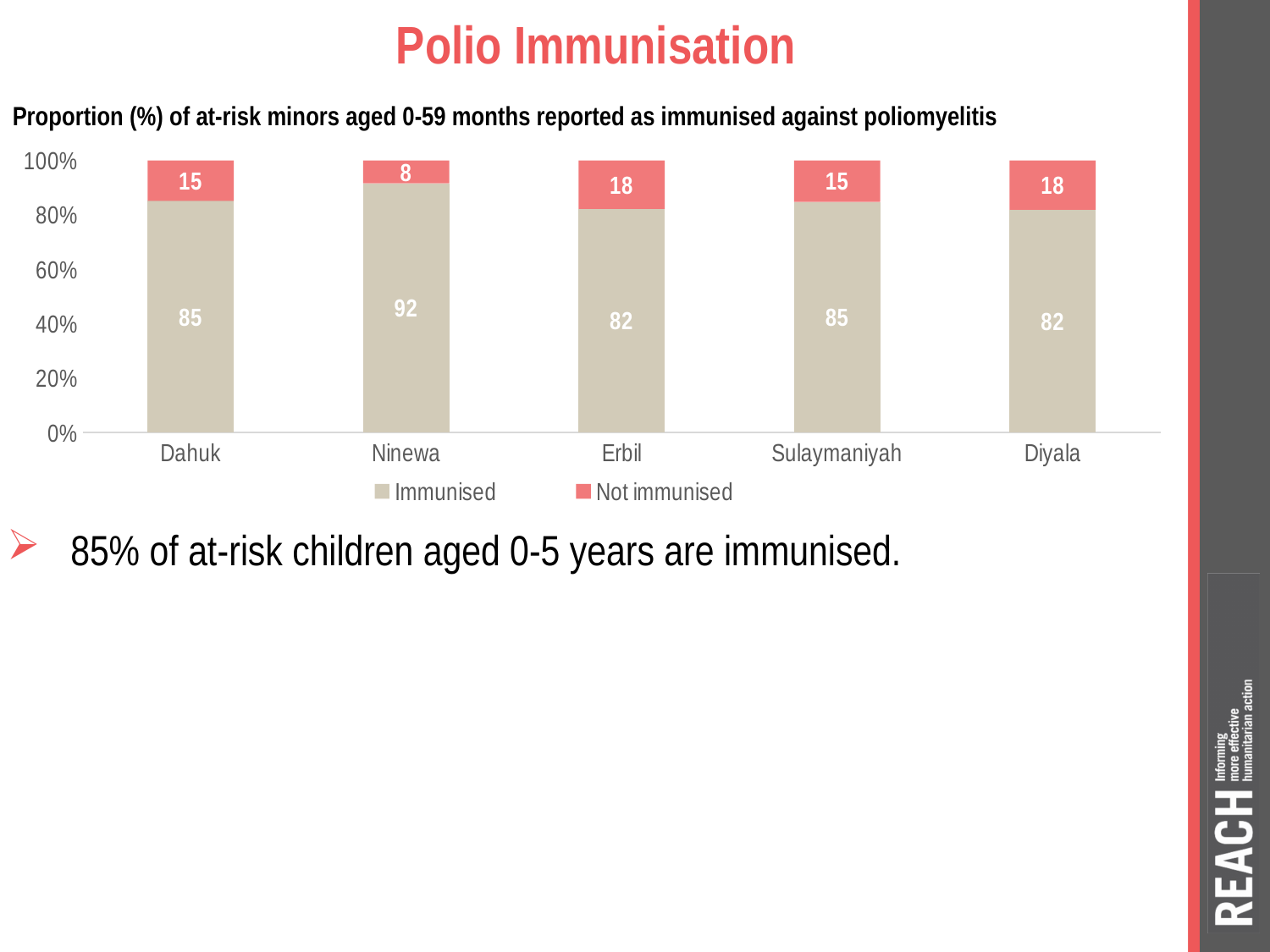
How many series does the legend list? 2 What is the Immunised value for Ninewa? 92 Which governorate has the highest Immunised value? Ninewa What kind of chart is shown on the slide? Stacked bar chart How many governorates are shown on the x axis? 5 What is the Not immunised value for Erbil? 18 What is the Immunised value for Sulaymaniyah? 85 Which is larger, the Not immunised value for Dahuk or for Erbil? Erbil What is the total of the stacked bar for Dahuk? 100 Which governorate has the lowest Not immunised value? Ninewa Which series is shown in red in the legend? Not immunised What is the difference between the Immunised values for Ninewa and Diyala? 10